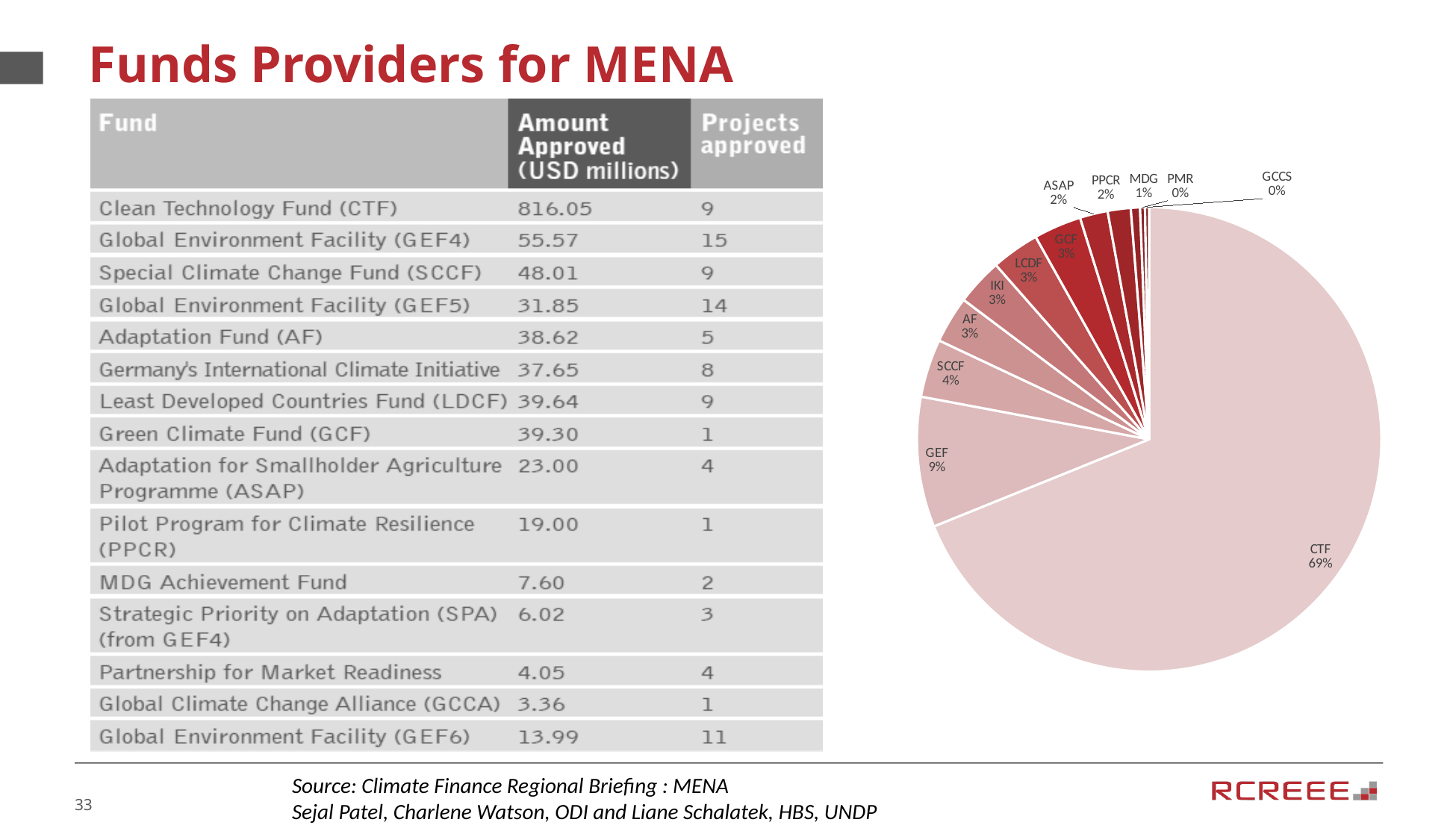
What kind of chart is shown on the slide? pie chart What is the difference in percentage points between the CTF share and the GEF share in the pie chart? 60 Which fund has the largest slice in the pie chart? CTF What percentage is shown for PMR in the pie chart? 0% How many slices are labelled in the pie chart? 12 What share of the pie chart does CTF account for? 69% What percentage is shown for MDG in the pie chart? 1% What is the title of the slide containing the pie chart? Funds Providers for MENA What percentage is shown for ASAP in the pie chart? 2% Which is larger in the pie chart, the share for GEF or the share for SCCF? GEF What percentage is shown for SCCF in the pie chart? 4% What percentage is shown for GEF in the pie chart? 9%